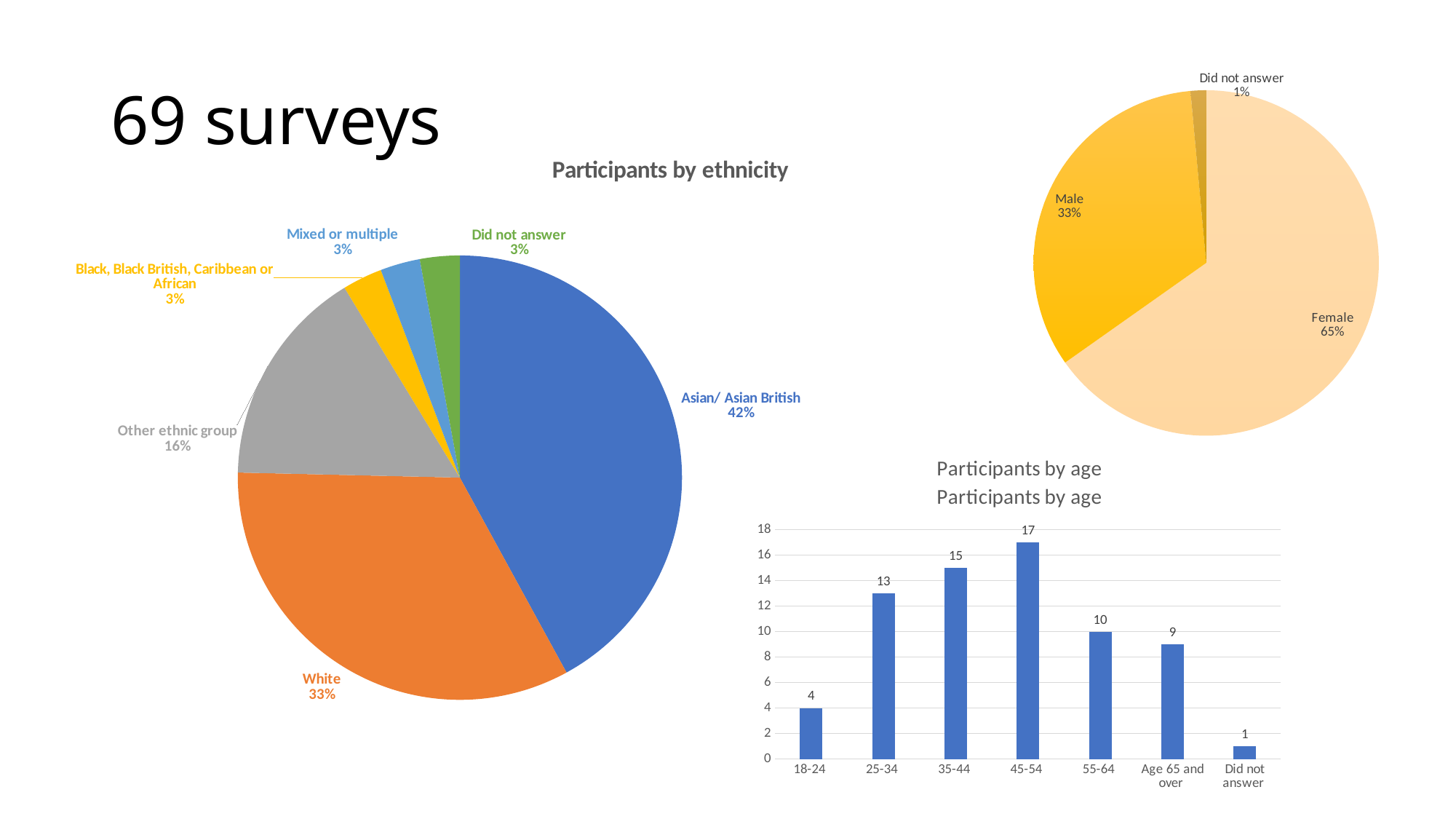
In the 'Participants by age' chart, what is the difference between the 35-44 and 55-64 values? 5 In the 'Participants by ethnicity' pie chart, what share of participants are White? 33% How many categories does the 'Participants by ethnicity' pie chart show? 6 In the 'Participants by ethnicity' pie chart, what share of participants are Asian/ Asian British? 42% In the gender pie chart at the top right, what is the difference between the Female and Male shares? 32% In the 'Participants by ethnicity' pie chart, what is the share for 'Other ethnic group'? 16% In the gender pie chart at the top right, what share of participants are Male? 33% In the 'Participants by ethnicity' pie chart, which category has the largest share? Asian/ Asian British What kind of chart is 'Participants by age'? Bar chart In the 'Participants by age' chart, what is the value for the 45-54 age group? 17 In the 'Participants by age' chart, which age group has the lowest value? Did not answer